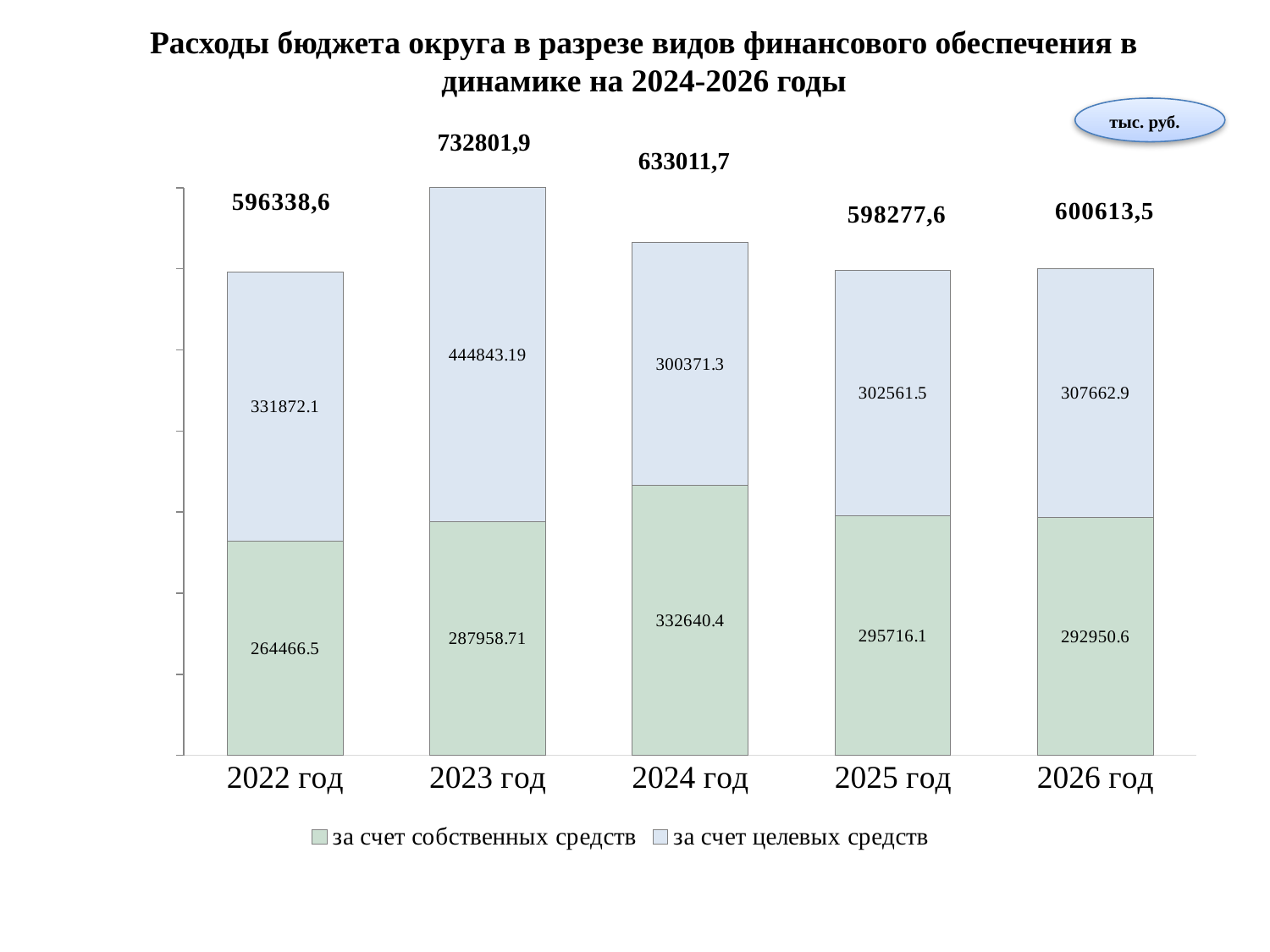
How many series does the legend list? 2 Which year has the lowest total budget expenditure? 2022 год In 2024 год, which is larger: 'за счет собственных средств' or 'за счет целевых средств'? за счет собственных средств What unit is indicated in the oval label at the top right of the chart? тыс. руб. Which year has the highest total budget expenditure? 2023 год What type of chart is shown on the slide? stacked bar chart How many years (categories) are shown on the x axis? 5 What is the total printed above the bar for 2026 год? 600613,5 What is the difference between the 'за счет целевых средств' values for 2026 год and 2025 год? 5101.4 What is the value for 'за счет собственных средств' in 2024 год? 332640.4 What is the value for 'за счет целевых средств' in 2023 год? 444843.19 Which series is shown in green in the legend? за счет собственных средств